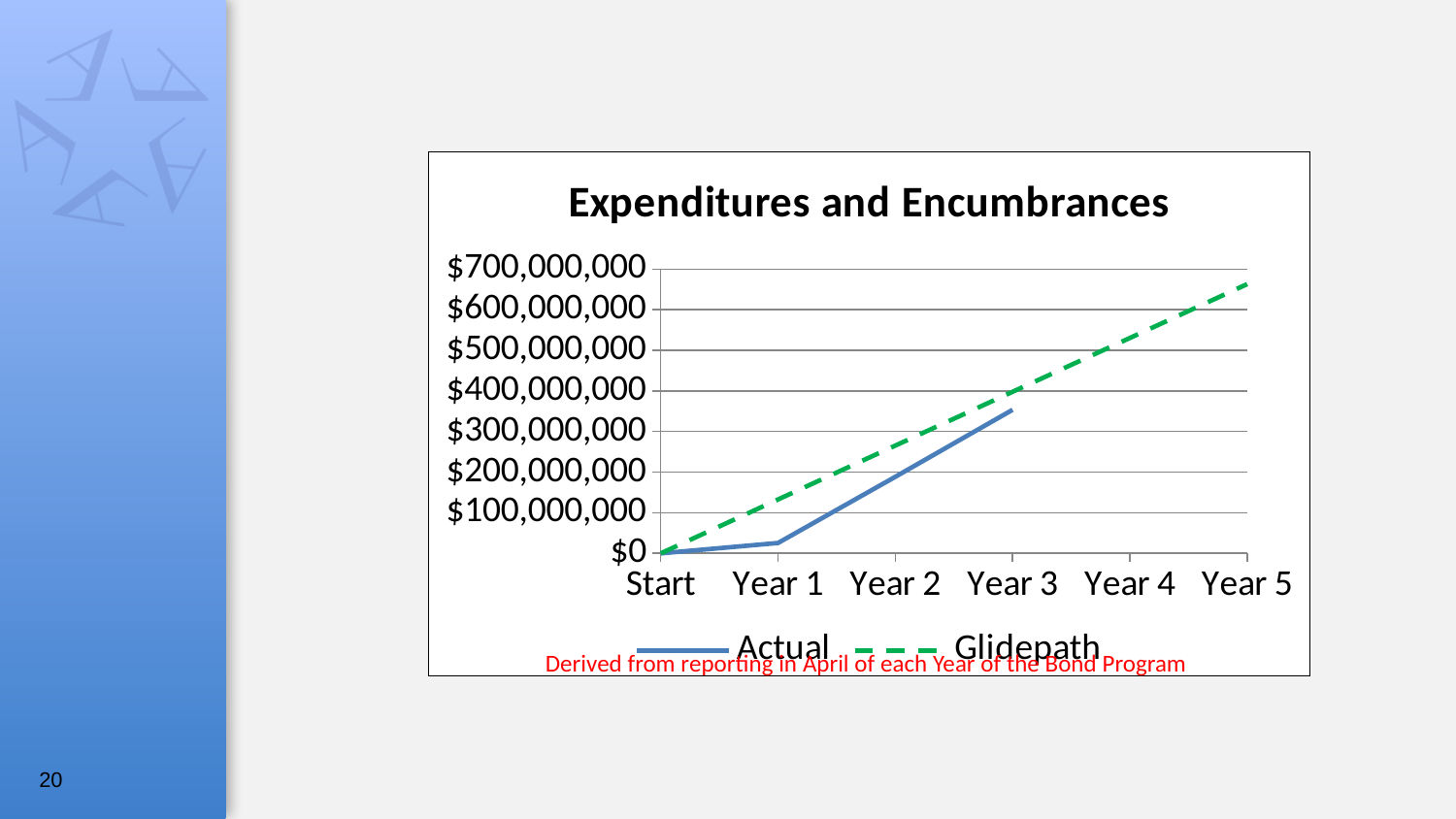
Is the Actual value at Year 3 greater or less than $400,000,000? less How many categories are shown on the x axis? 6 What is the title of the chart? Expenditures and Encumbrances Is the Glidepath value at Year 5 greater or less than $600,000,000? greater Which series is drawn with a dashed line? Glidepath At Year 2, which series has the higher value, Actual or Glidepath? Glidepath How many series does the legend list? 2 Is the Actual value at Year 1 greater or less than $100,000,000? less Does the Actual series rise or fall from Start to Year 3? rise What kind of chart is shown on the slide? line chart